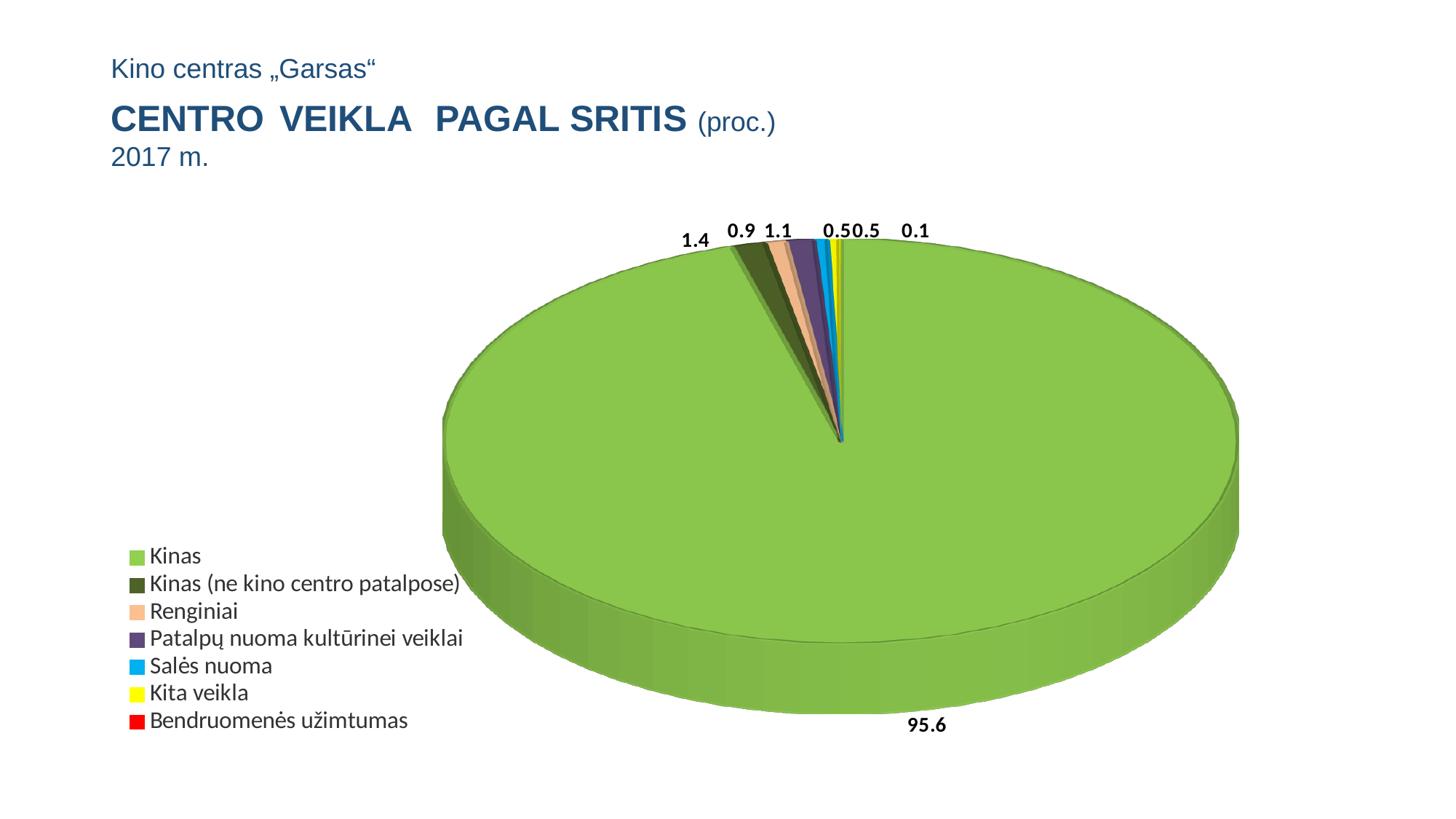
What is the value for Kinas? 95.6 How many categories does the legend list? 7 What colour is the slice for Kita veikla? yellow Which category has the smallest share of the pie? Bendruomenės užimtumas What is the value for Bendruomenės užimtumas? 0.1 What is the difference between the values for Kinas (ne kino centro patalpose) and Renginiai? 0.5 What kind of chart is shown on the slide? pie chart What is the value for Renginiai? 0.9 What is the value for Patalpų nuoma kultūrinei veiklai? 1.1 Which category has the largest share of the pie? Kinas Which is larger, the value for Patalpų nuoma kultūrinei veiklai or the value for Salės nuoma? Patalpų nuoma kultūrinei veiklai What is the value for Kinas (ne kino centro patalpose)? 1.4